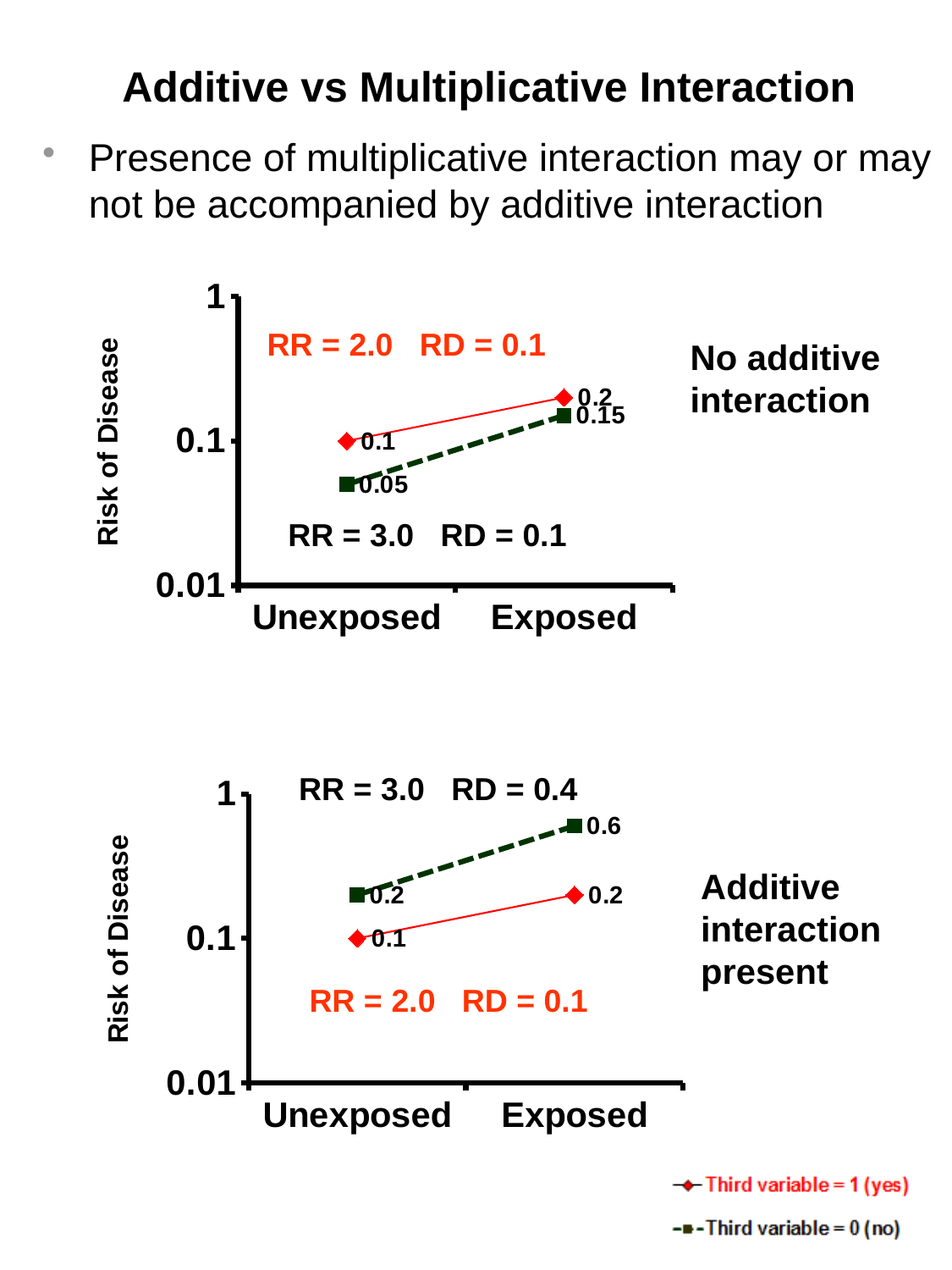
In the top chart (No additive interaction), what is the risk of disease for the Exposed group when Third variable = 1 (yes)? 0.2 In the bottom chart (Additive interaction present), what is the difference in risk between Exposed and Unexposed for Third variable = 0 (no)? 0.4 In the top chart (No additive interaction), which series has the higher risk for the Unexposed group, Third variable = 1 (yes) or Third variable = 0 (no)? Third variable = 1 (yes) In the bottom chart (Additive interaction present), which series has the higher risk for the Exposed group, Third variable = 1 (yes) or Third variable = 0 (no)? Third variable = 0 (no) In the top chart (No additive interaction), what is the risk of disease for the Unexposed group when Third variable = 0 (no)? 0.05 In the bottom chart (Additive interaction present), does the risk of disease rise or fall from Unexposed to Exposed for Third variable = 0 (no)? rise In the top chart (No additive interaction), what is the risk of disease for the Exposed group when Third variable = 0 (no)? 0.15 In the top chart (No additive interaction), what is the difference in risk between Exposed and Unexposed for Third variable = 0 (no)? 0.1 How many series does the legend list for the charts on this slide? 2 In the bottom chart (Additive interaction present), what is the risk of disease for the Unexposed group when Third variable = 1 (yes)? 0.1 In the bottom chart (Additive interaction present), what is the risk of disease for the Exposed group when Third variable = 0 (no)? 0.6 What type of chart is the top chart (No additive interaction)? line chart